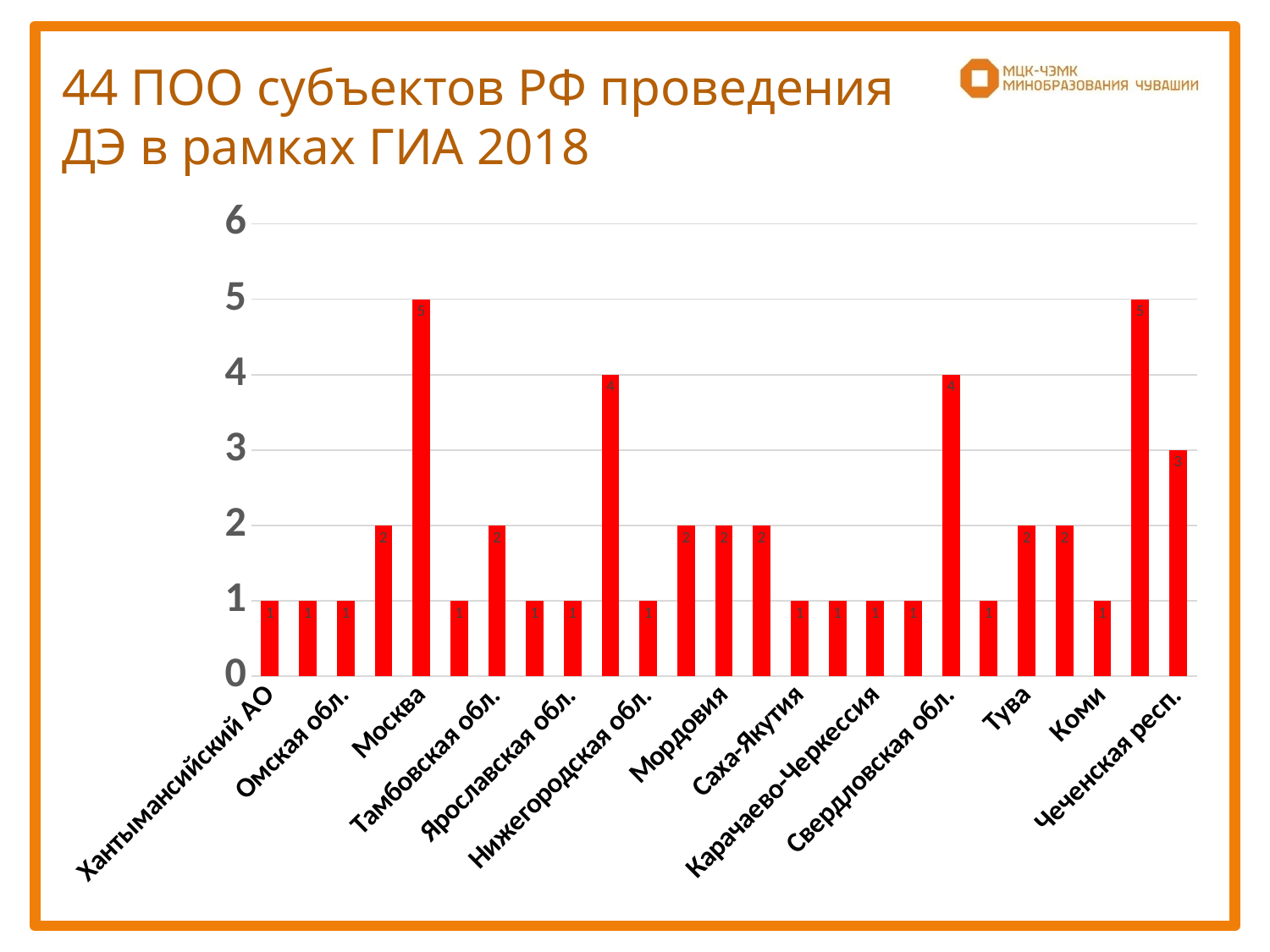
What kind of chart is shown on the slide? Bar chart What is the value for Коми? 1 Which is larger, the value for Москва or the value for Свердловская обл.? Москва What is the title of the slide? 44 ПОО субъектов РФ проведения ДЭ в рамках ГИА 2018 What is the value for Тува? 2 Which is larger, the value for Чеченская респ. or the value for Тува? Чеченская респ. What is the value for Мордовия? 2 What is the value for Чеченская респ.? 3 What is the value for Свердловская обл.? 4 What is the value for Москва? 5 What is the difference between the values for Москва and Чеченская респ.? 2 What is the difference between the values for Свердловская обл. and Коми? 3